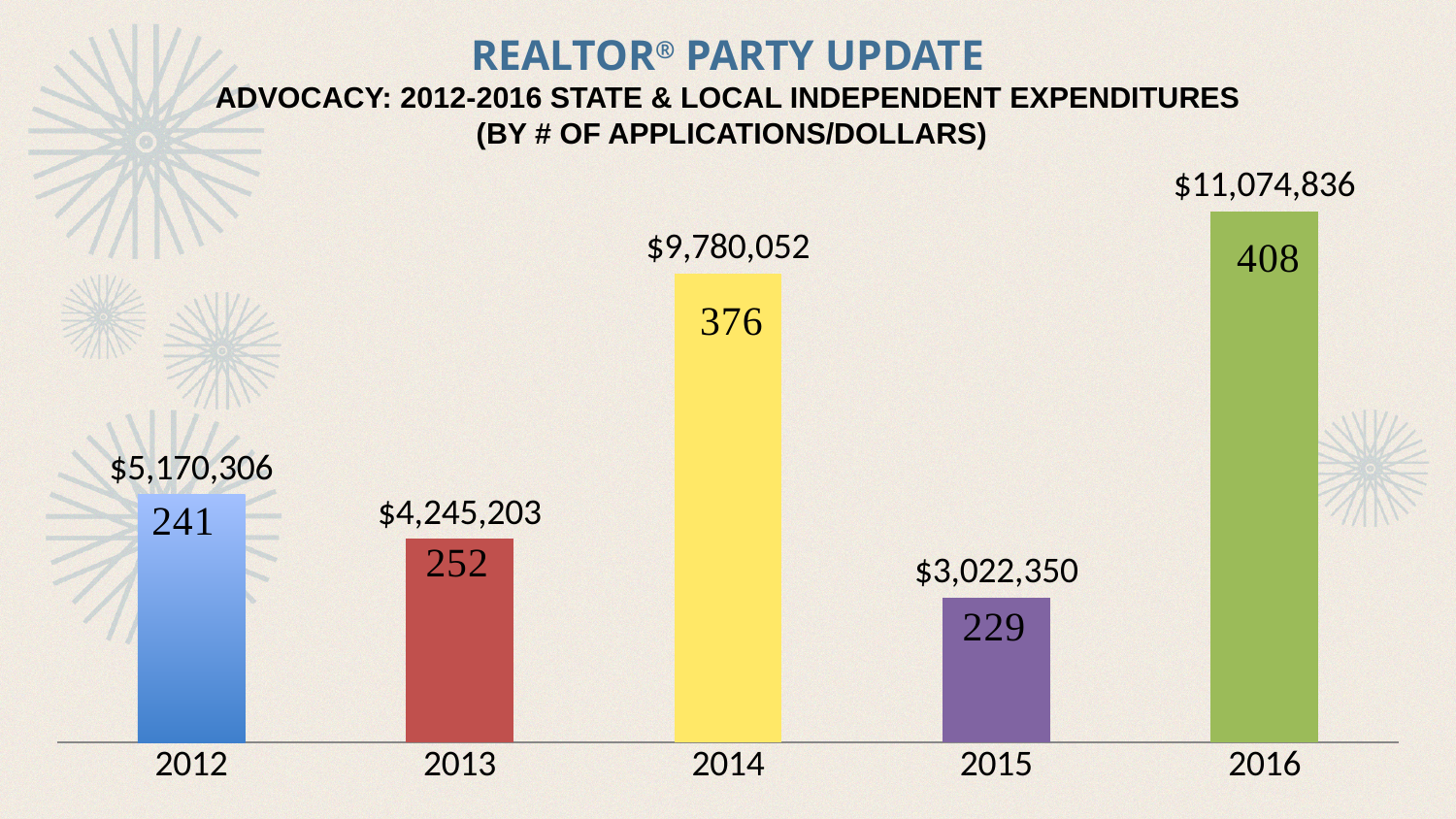
What was the dollar amount of state & local independent expenditures in 2014? $9,780,052 Which year has the lowest number of applications? 2015 How many applications are shown inside the bar for 2016? 408 How many years are shown on the x axis of the chart? 5 Which year has the lowest dollar amount of independent expenditures? 2015 Which year had more applications, 2012 or 2013? 2013 Which year has the highest dollar amount of independent expenditures? 2016 Which year had higher dollar expenditures, 2012 or 2013? 2012 What type of chart is shown on the slide? Bar chart What is the difference in dollars between 2016 and 2015 expenditures? $8,052,486 What was the dollar amount of independent expenditures in 2015? $3,022,350 How many more applications were there in 2016 than in 2012? 167